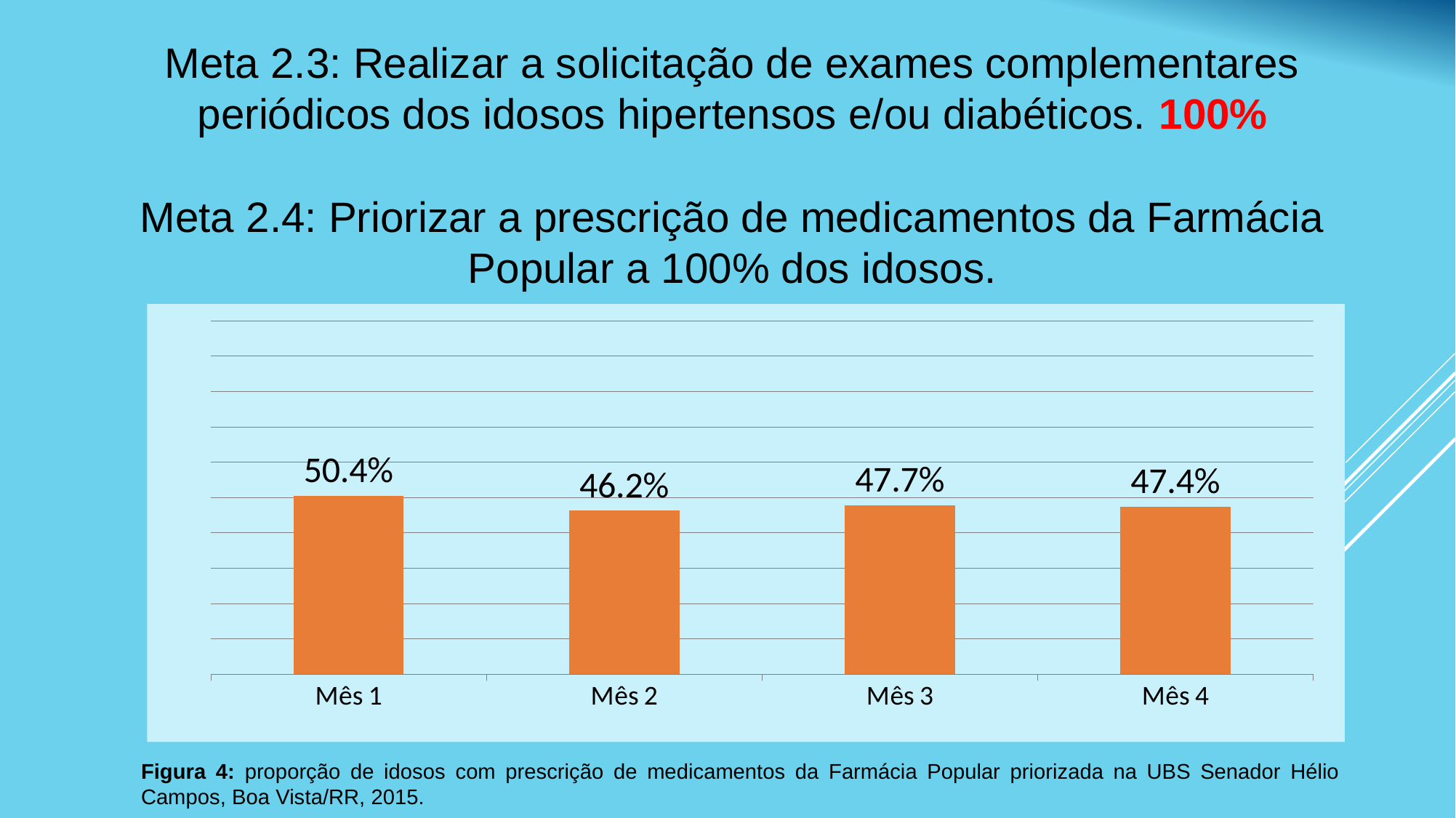
How many months are shown on the x axis? 4 Which month has the lowest value? Mês 2 What is the value for Mês 4? 47.4% What is the difference between the values for Mês 1 and Mês 2? 4.2% What is the value for Mês 1? 50.4% What kind of chart is shown on the slide? Bar chart Which month has the highest value? Mês 1 What is the value for Mês 3? 47.7% What is the value for Mês 2? 46.2% Which is larger, the value for Mês 3 or the value for Mês 4? Mês 3 What figure number is given in the caption below the chart? Figura 4 Does the value rise or fall from Mês 1 to Mês 2? Fall